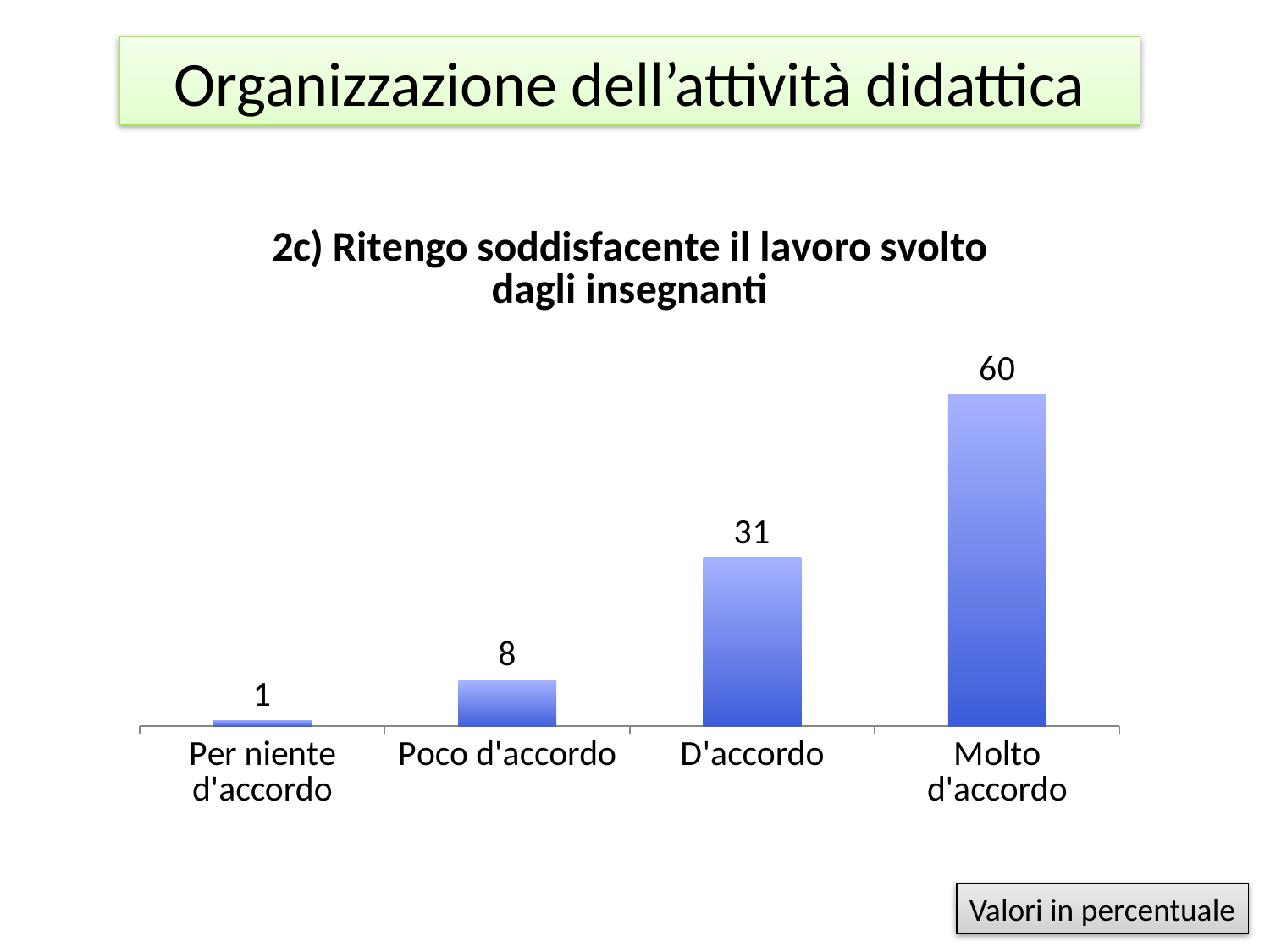
What is the value for "Per niente d'accordo"? 1 What is the difference between the values for "Molto d'accordo" and "D'accordo"? 29 How many categories are shown on the x axis? 4 Which is larger, the value for "Poco d'accordo" or the value for "D'accordo"? D'accordo What is the value for "Molto d'accordo"? 60 What is the title of the chart? 2c) Ritengo soddisfacente il lavoro svolto dagli insegnanti What kind of chart is shown on the slide? Bar chart Do the values rise or fall from left to right along the x axis? Rise Which category has the highest value? Molto d'accordo What is the value for "Poco d'accordo"? 8 What is the value for "D'accordo"? 31 Which category has the lowest value? Per niente d'accordo